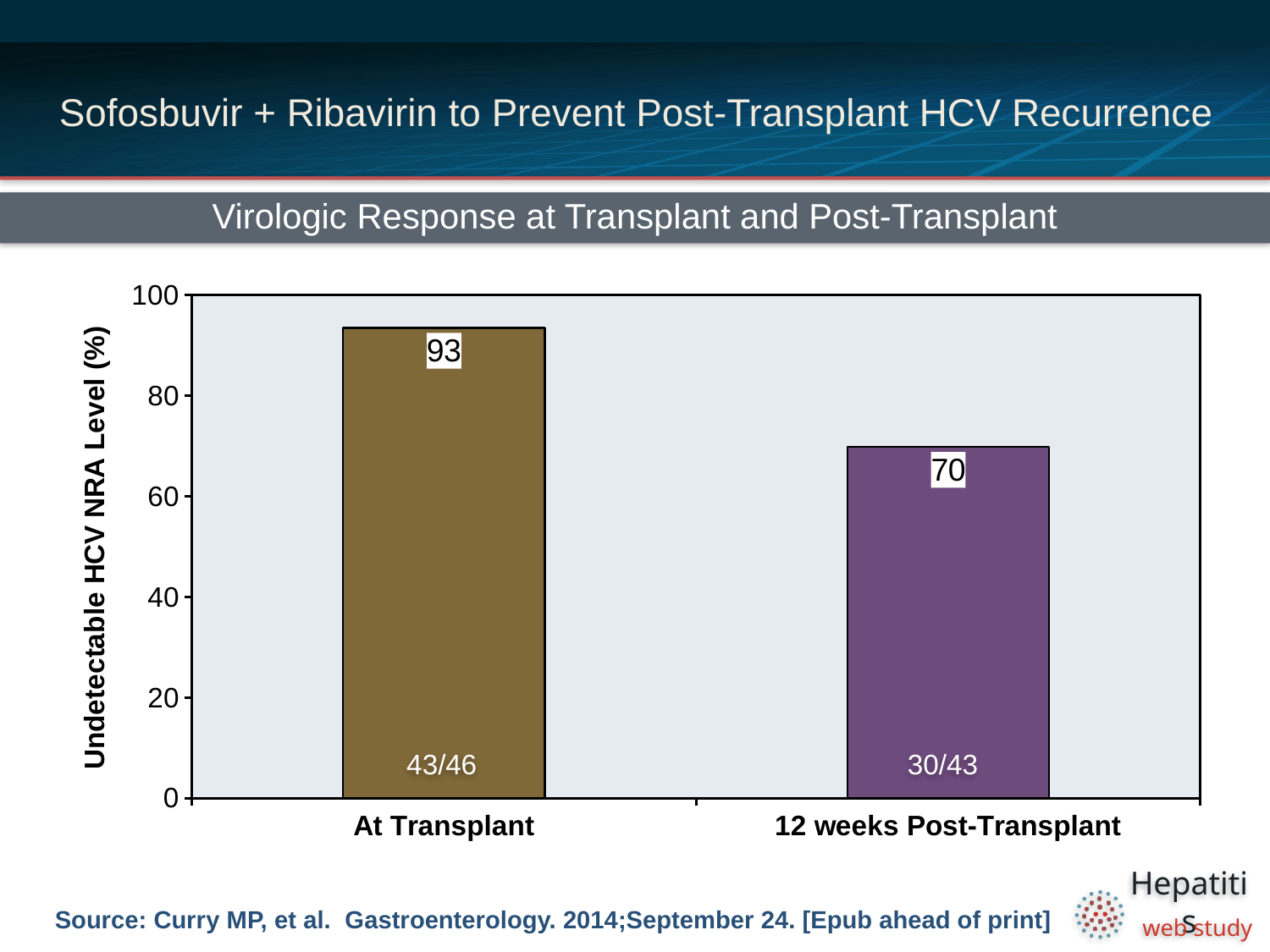
What fraction of patients is printed inside the At Transplant bar? 43/46 What is the value for At Transplant? 93 What is the difference between the At Transplant and 12 weeks Post-Transplant values? 23 Do the values rise or fall from At Transplant to 12 weeks Post-Transplant? fall Which category has the lowest value? 12 weeks Post-Transplant What is the y-axis label of the chart? Undetectable HCV NRA Level (%) What is the value for 12 weeks Post-Transplant? 70 Is the value for 12 weeks Post-Transplant greater or less than 80? less Which is larger, the value for At Transplant or for 12 weeks Post-Transplant? At Transplant How many categories are shown on the x axis? 2 What kind of chart is shown? bar chart Which category has the highest value? At Transplant